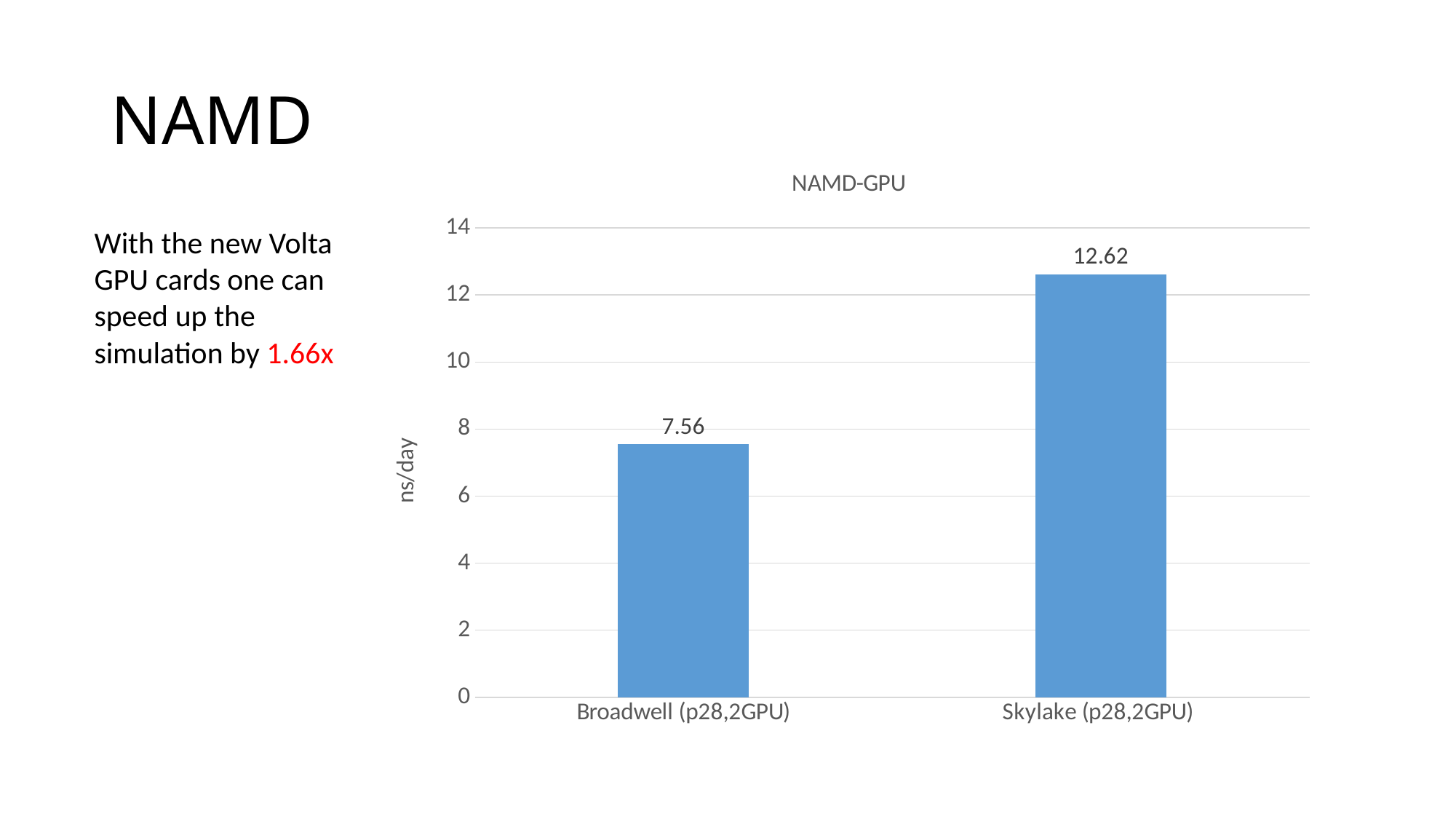
What is the label of the y axis? ns/day What is the difference between the values for Skylake (p28,2GPU) and Broadwell (p28,2GPU)? 5.06 Is the value for Broadwell (p28,2GPU) greater or less than 8? less How many categories are shown on the x axis? 2 Is the value for Skylake (p28,2GPU) greater or less than 10? greater What is the value for Broadwell (p28,2GPU)? 7.56 Which category has the lowest value? Broadwell (p28,2GPU) What kind of chart is shown on the slide? bar chart What is the value for Skylake (p28,2GPU)? 12.62 What is the title of the chart? NAMD-GPU Which is larger, the value for Broadwell (p28,2GPU) or Skylake (p28,2GPU)? Skylake (p28,2GPU) Which category has the highest value? Skylake (p28,2GPU)